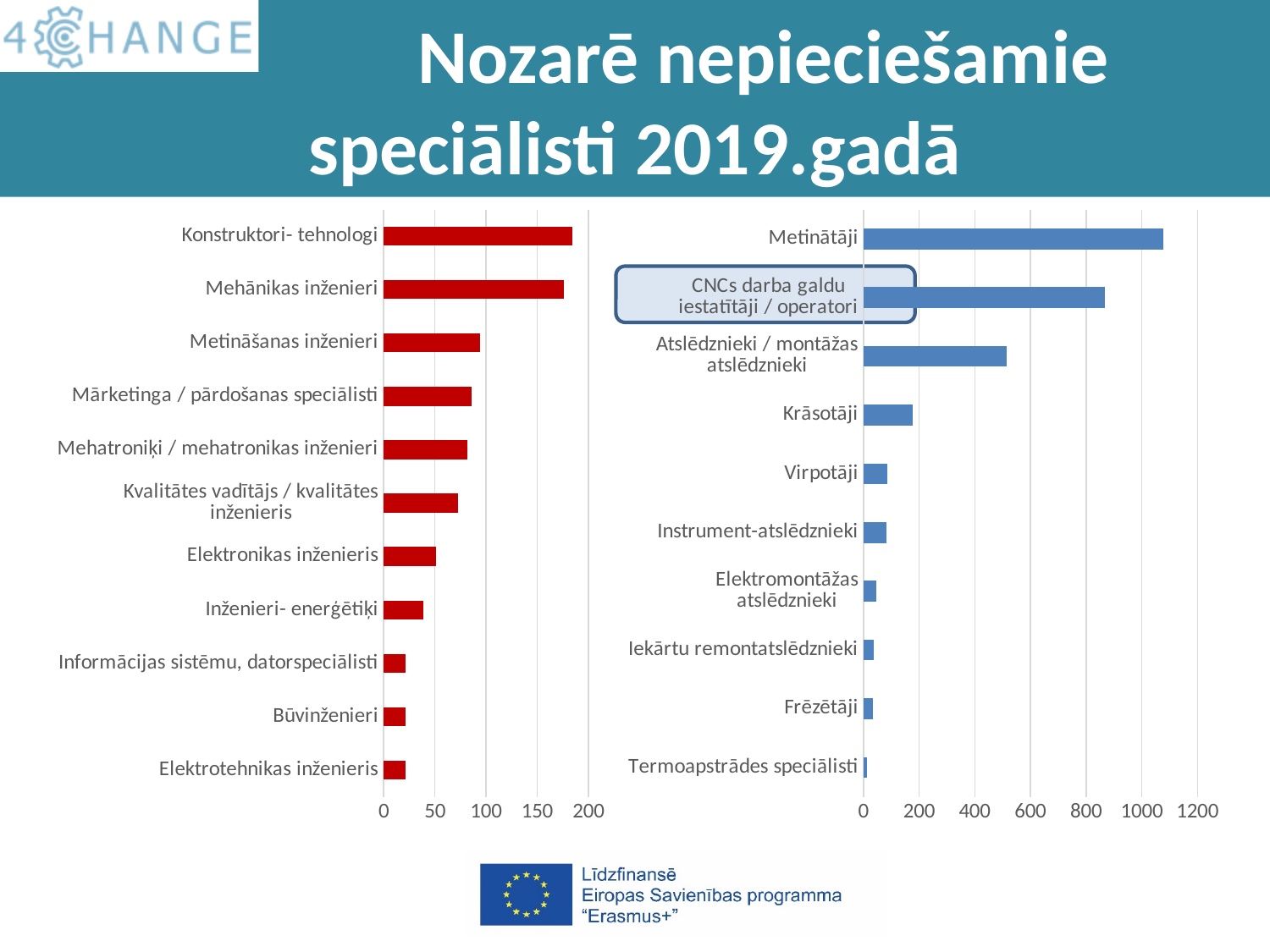
In the left chart (red bars), which is larger: Mehānikas inženieri or Metināšanas inženieri? Mehānikas inženieri How many categories are shown in the left chart (red bars)? 11 In the right chart (blue bars), which category has the highest value? Metinātāji In the right chart (blue bars), which category has the lowest value? Termoapstrādes speciālisti In the left chart (red bars), is the value for Konstruktori- tehnologi greater or less than 150? greater What type of chart is the right chart (blue bars)? Bar chart In the left chart (red bars), which category has the highest value? Konstruktori- tehnologi In the left chart (red bars), is the value for Inženieri- enerģētiķi greater or less than 50? less In the right chart (blue bars), which is larger: Krāsotāji or Virpotāji? Krāsotāji In the right chart (blue bars), is the value for Krāsotāji greater or less than 200? less